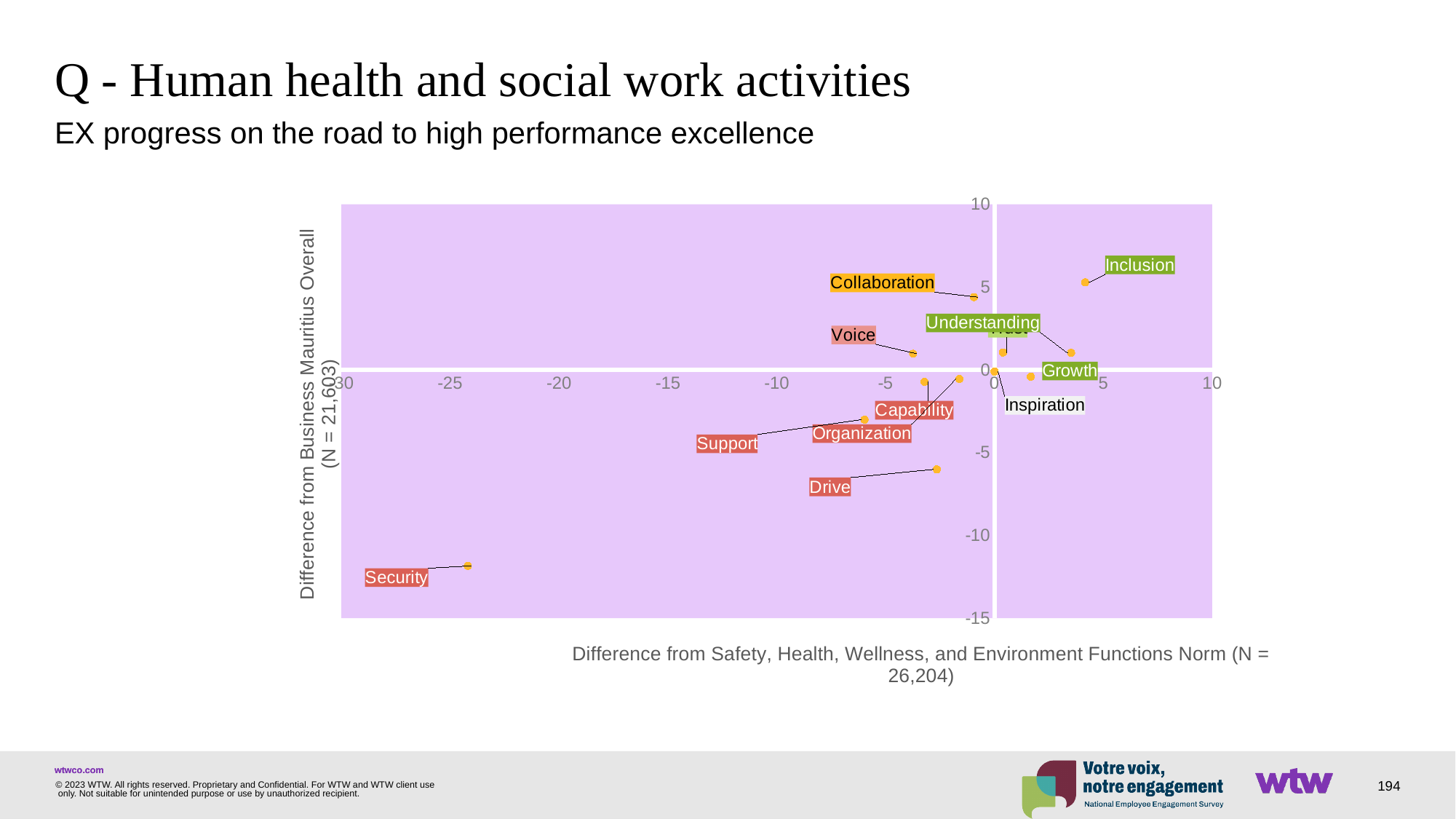
Is the vertical-axis value for Security greater or less than -10? less What kind of chart is shown on the slide? scatter chart Is the horizontal-axis value for Collaboration greater or less than -5? greater Is the horizontal-axis value for Security greater or less than -20? less What is the title of the horizontal axis? Difference from Safety, Health, Wellness, and Environment Functions Norm (N = 26,204) Which point has a higher vertical-axis value, Inclusion or Drive? Inclusion What is the title of the vertical axis? Difference from Business Mauritius Overall (N = 21,603) Which labeled point has the lowest value on the vertical axis (Difference from Business Mauritius Overall)? Security Which labeled point has the lowest value on the horizontal axis (Difference from Safety, Health, Wellness, and Environment Functions Norm)? Security